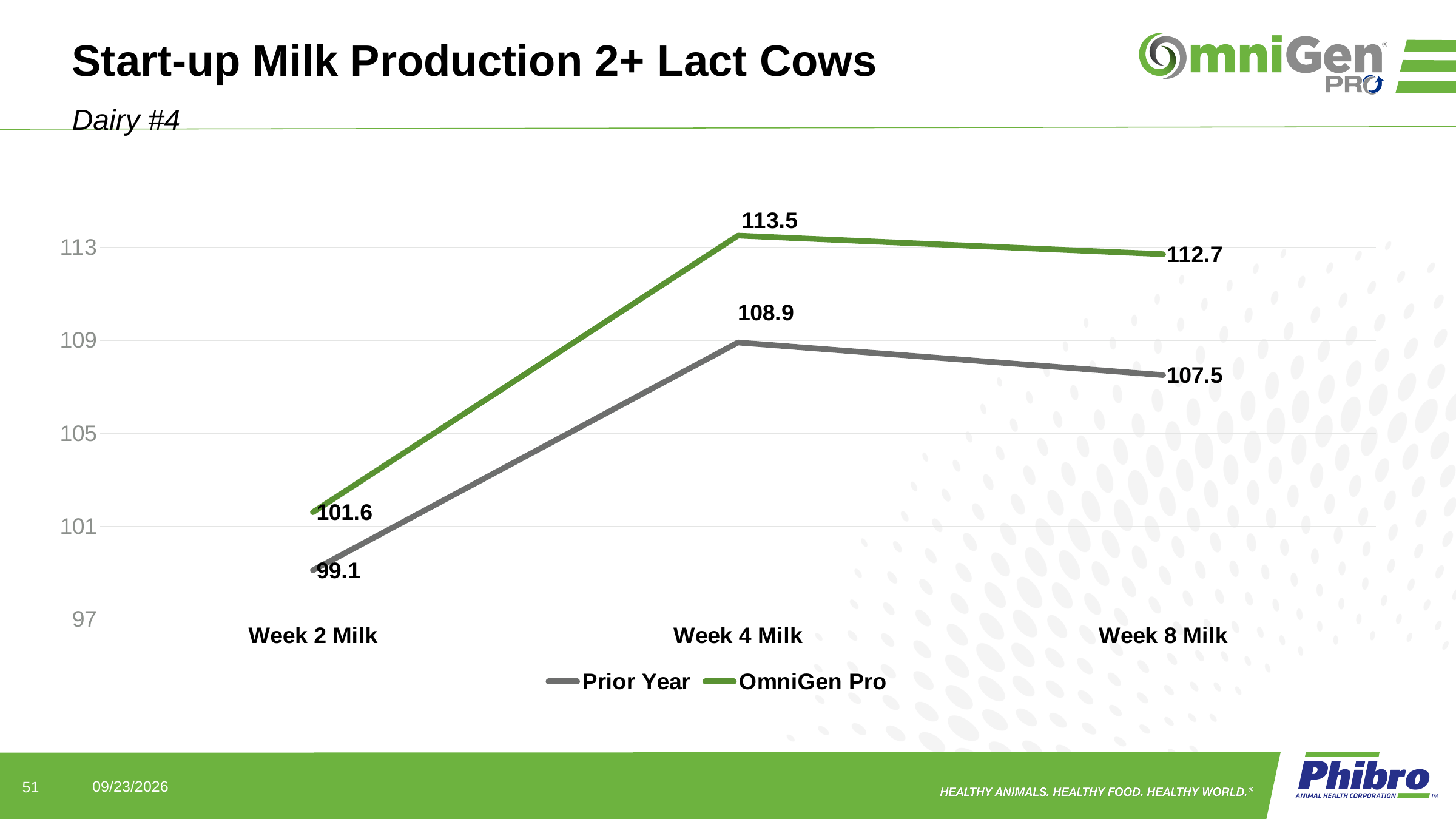
What is the difference between OmniGen Pro and Prior Year at Week 8 Milk? 5.2 At which week is the Prior Year series lowest? Week 2 Milk At which week does the OmniGen Pro series reach its highest value? Week 4 Milk What is the difference between OmniGen Pro and Prior Year at Week 4 Milk? 4.6 What is the Prior Year value at Week 8 Milk? 107.5 What is the Prior Year value at Week 2 Milk? 99.1 How many categories are shown on the x axis? 3 What kind of chart is shown on the slide? Line chart What is the OmniGen Pro value at Week 4 Milk? 113.5 How many series does the legend list? 2 Which series has the higher value at Week 2 Milk, Prior Year or OmniGen Pro? OmniGen Pro What is the OmniGen Pro value at Week 2 Milk? 101.6